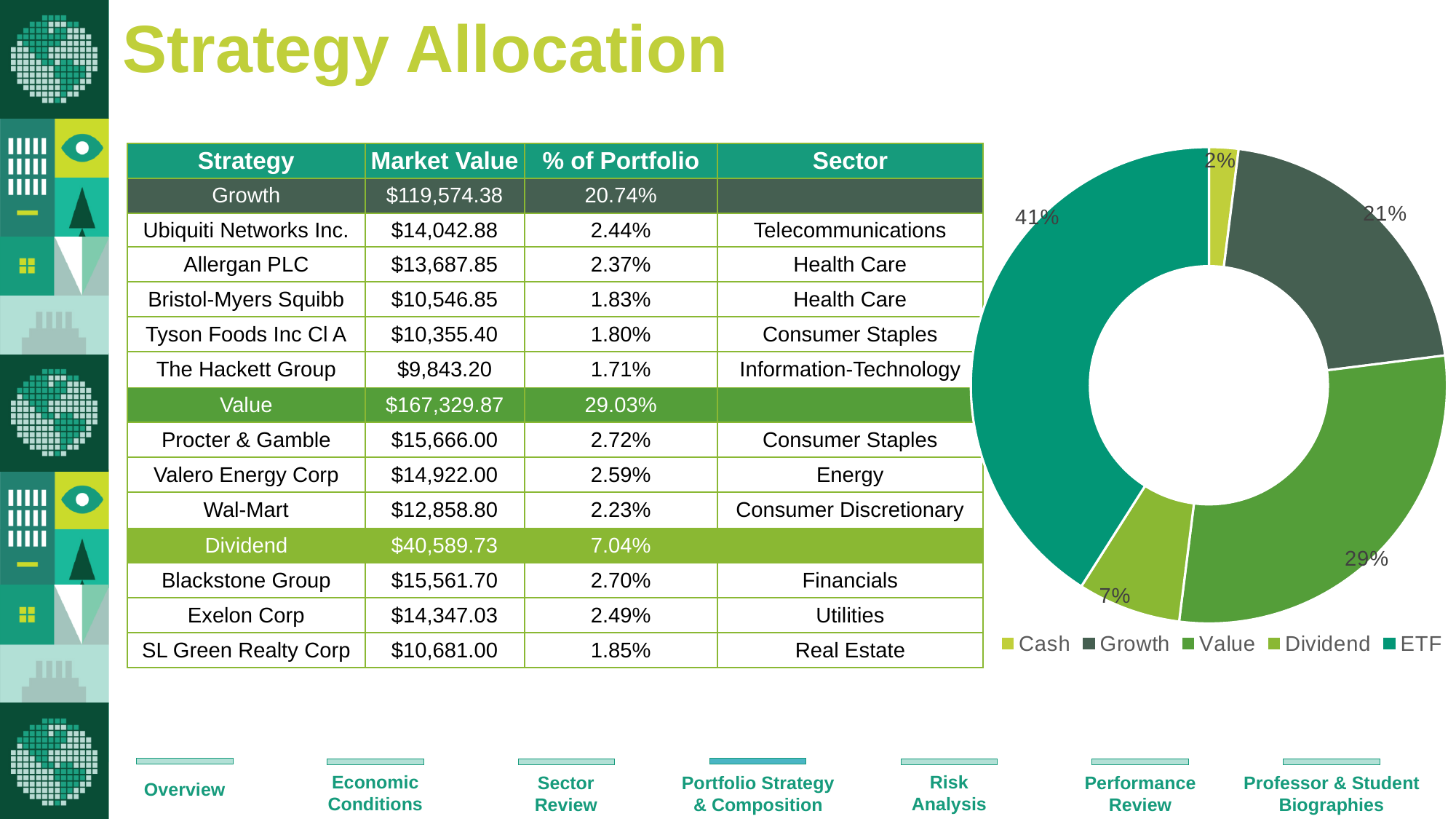
In the doughnut chart, what is the difference in percentage points between the ETF slice and the Value slice? 12 What percentage is shown for the Growth slice in the doughnut chart? 21% What percentage is shown for the Dividend slice in the doughnut chart? 7% Which category has the largest slice in the doughnut chart? ETF What percentage is shown for the Cash slice in the doughnut chart? 2% What kind of chart is shown on the right of the slide? Doughnut chart In the doughnut chart, which slice is larger: Growth or Dividend? Growth What is the first entry in the legend of the doughnut chart? Cash How many categories does the legend of the doughnut chart list? 5 Which category has the smallest slice in the doughnut chart? Cash What percentage is shown for the Value slice in the doughnut chart? 29% What share of the portfolio does the ETF slice represent in the doughnut chart? 41%